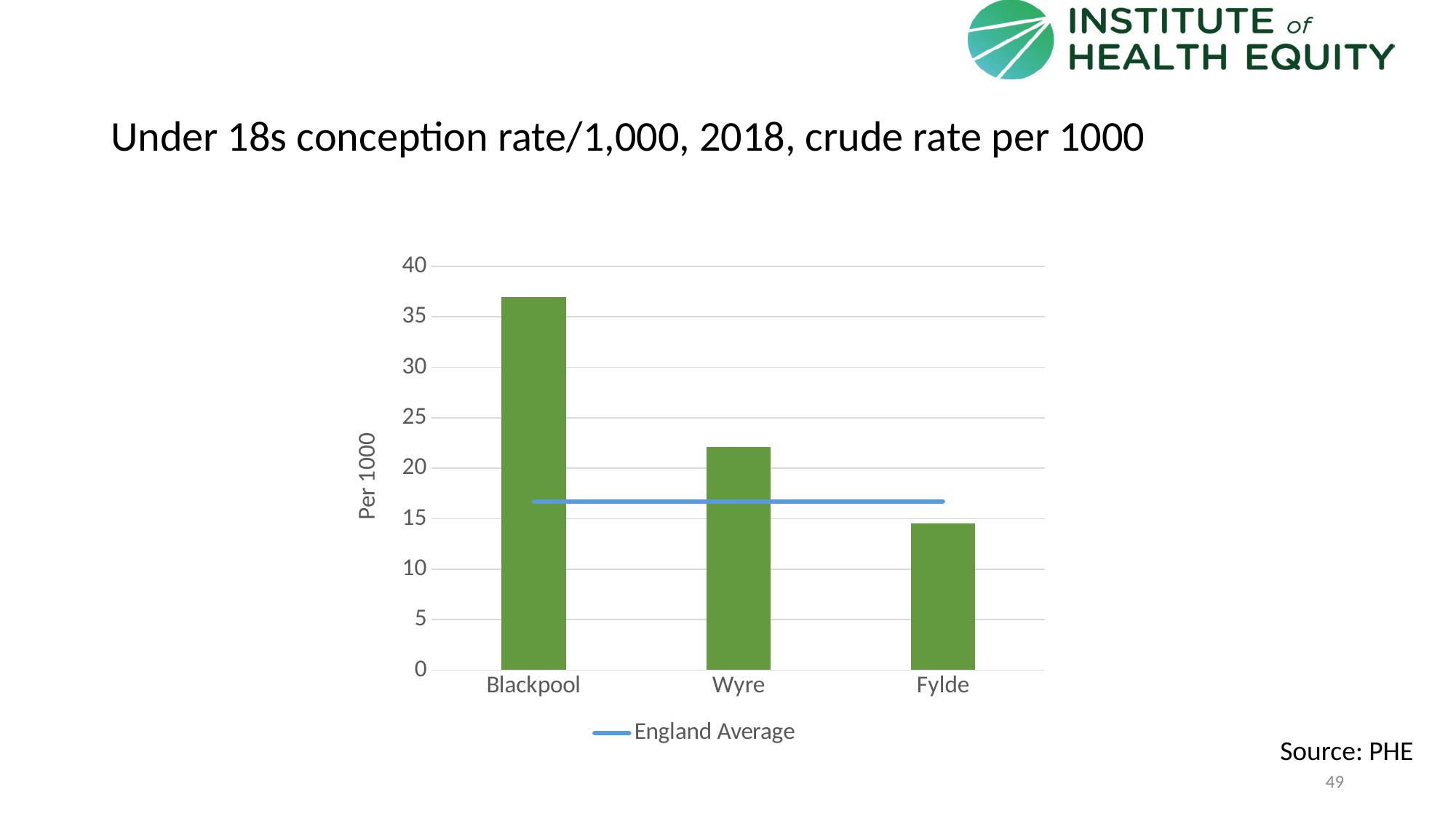
Is the value for Wyre greater or less than 20? greater How many areas are shown as bars on the chart? 3 Which area has the lowest under 18s conception rate? Fylde Is the value for Fylde greater or less than 15? less Which is larger, the value for Wyre or the value for Fylde? Wyre Do the bar values rise or fall from left to right across the x axis? Fall Is the England Average line greater or less than 20? less How many entries does the legend list? 1 What is the label on the vertical axis? Per 1000 Which area has the highest under 18s conception rate? Blackpool What kind of chart is shown on the slide? Combination bar and line chart (bars with an England Average line)